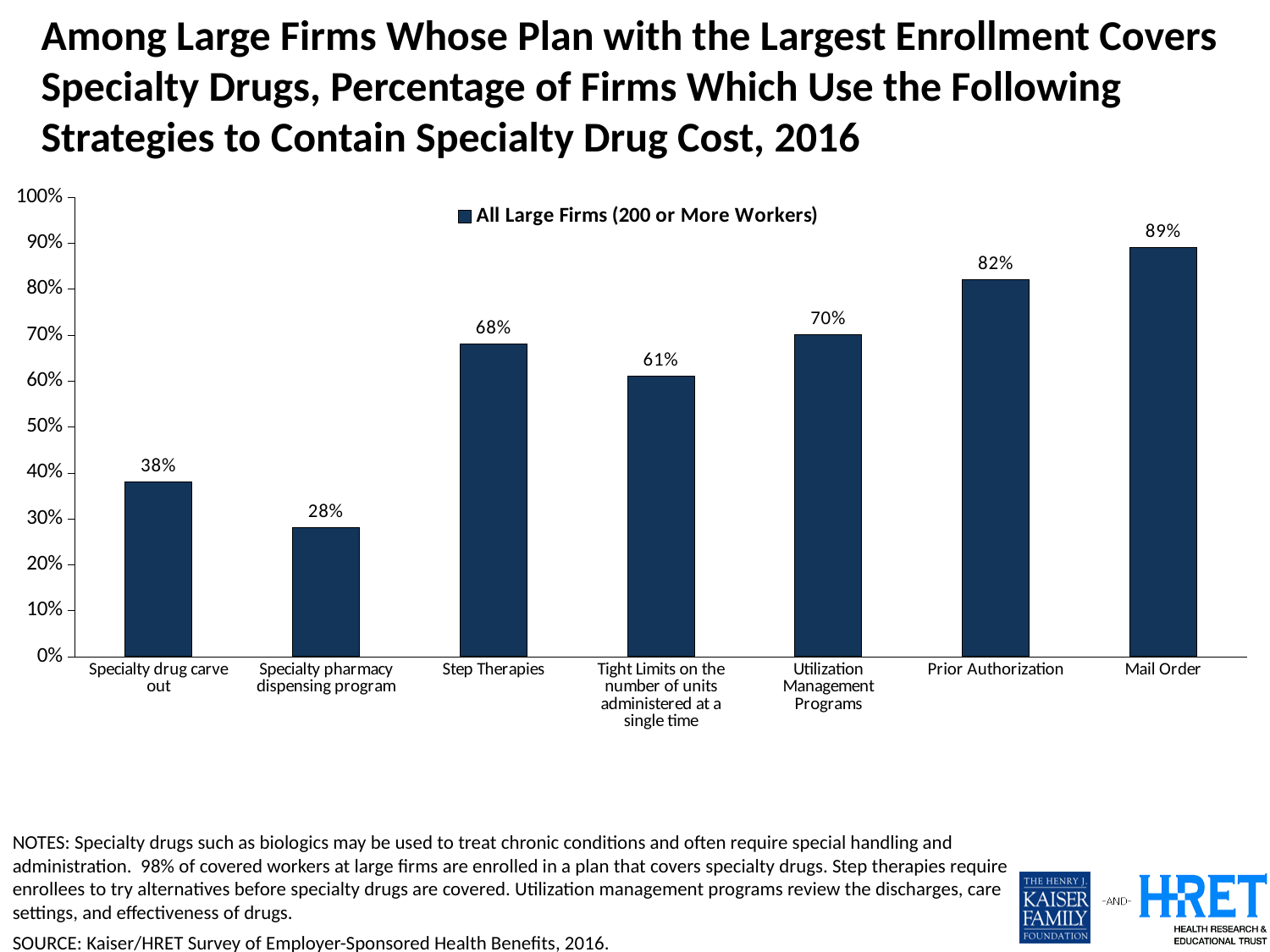
What percentage of large firms use Mail Order as a strategy to contain specialty drug cost? 89% Which strategy has the highest percentage of large firms using it? Mail Order What is the legend entry for the series shown in the chart? All Large Firms (200 or More Workers) Which strategy has the lowest percentage of large firms using it? Specialty pharmacy dispensing program How many series does the legend list? 1 What kind of chart is shown on the slide? Bar chart Which is larger: the percentage for Step Therapies or for Tight Limits on the number of units administered at a single time? Step Therapies What percentage of large firms use Step Therapies? 68% How many strategies are shown on the chart? 7 What percentage of large firms use a Specialty pharmacy dispensing program? 28% Is the value for Specialty drug carve out greater or less than 40%? less What is the difference in percentage points between Prior Authorization and Utilization Management Programs? 12